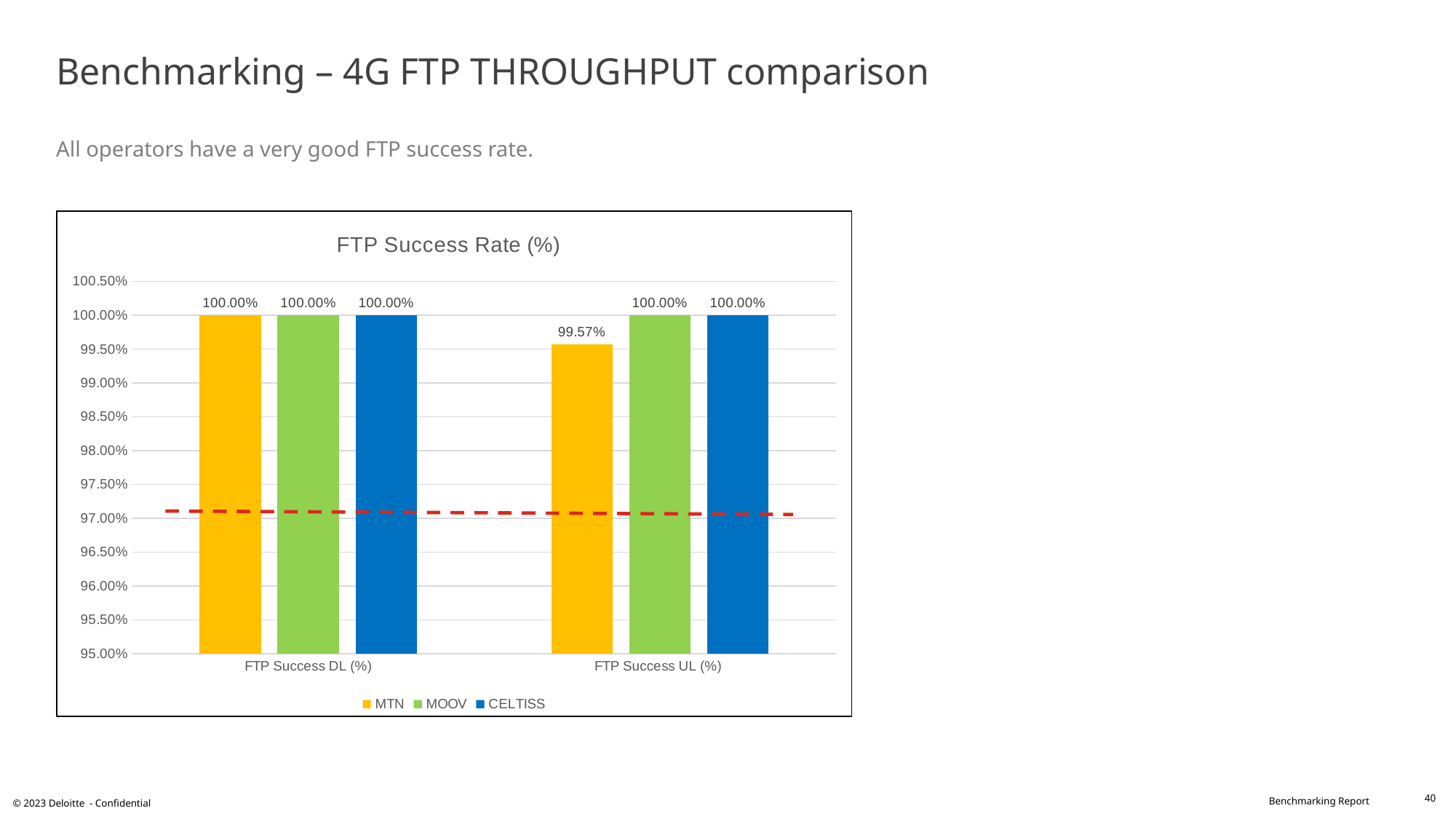
Which colour represents CELTISS in the chart? Blue Which operator has the lowest FTP Success UL (%) value? MTN What is the FTP Success DL (%) value for CELTISS? 100.00% What is the title of the chart? FTP Success Rate (%) What is the FTP Success UL (%) value for MOOV? 100.00% Which is larger: MTN's FTP Success DL (%) value or MTN's FTP Success UL (%) value? FTP Success DL (%) How many series does the legend list? 3 What kind of chart is shown on the slide? Bar chart What is the difference between MOOV's and MTN's FTP Success UL (%) values? 0.43% Is the FTP Success UL (%) value for MTN greater or less than 99.00%? greater What is the FTP Success UL (%) value for MTN? 99.57% How many categories are shown on the x axis of the chart? 2